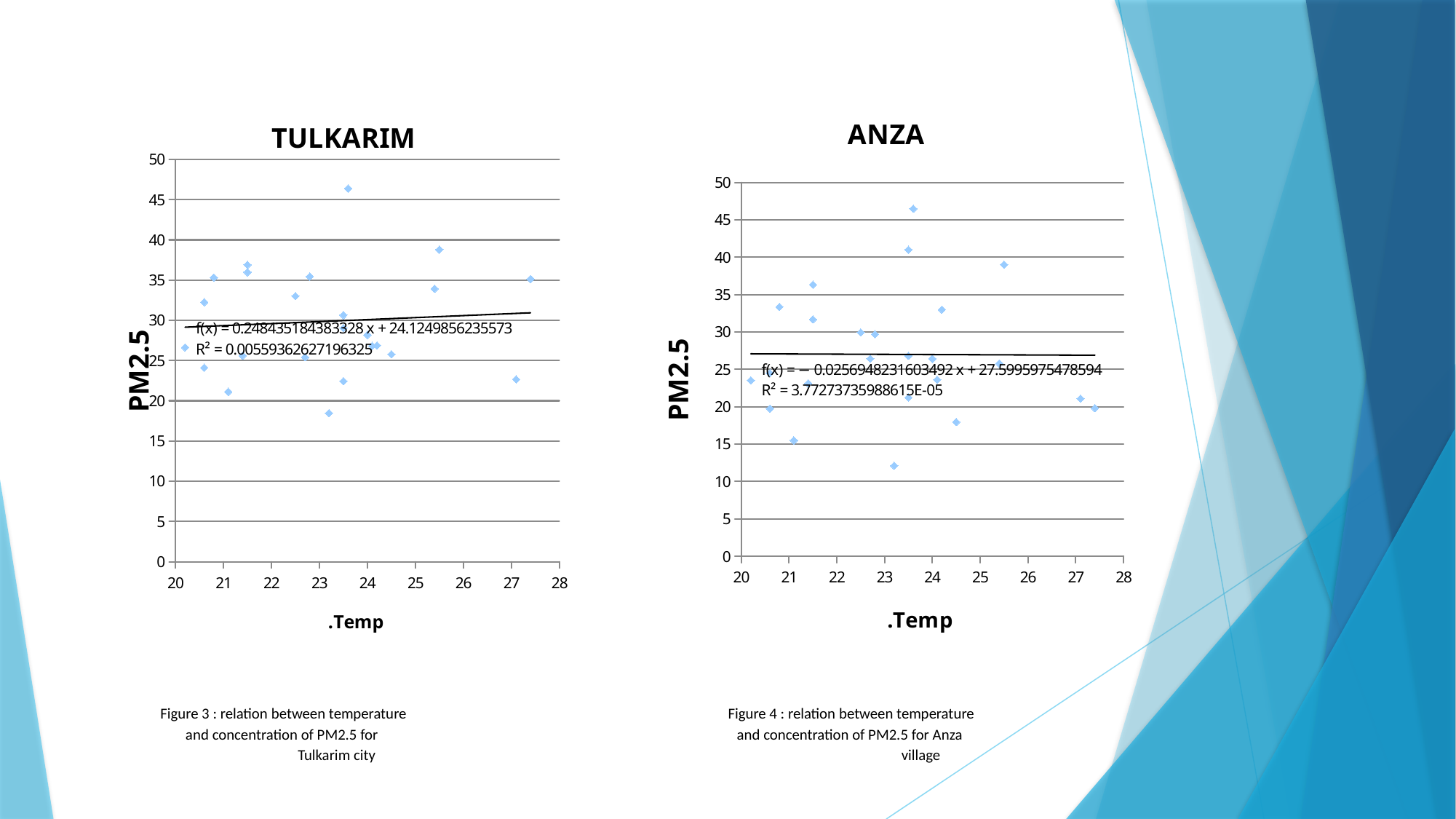
What is the label on the vertical axis of the ANZA chart? PM2.5 In the TULKARIM chart, does the fitted trendline rise or fall as temperature increases? rise What is the R² value shown on the TULKARIM chart? 0.00559362627196325 What kind of chart is the ANZA chart? scatter chart What kind of chart is the TULKARIM chart? scatter chart In the TULKARIM chart, is the highest plotted PM2.5 value greater or less than 45? greater In the ANZA chart, is the highest plotted PM2.5 value greater or less than 45? greater In the ANZA chart, is the lowest plotted PM2.5 value greater or less than 15? less